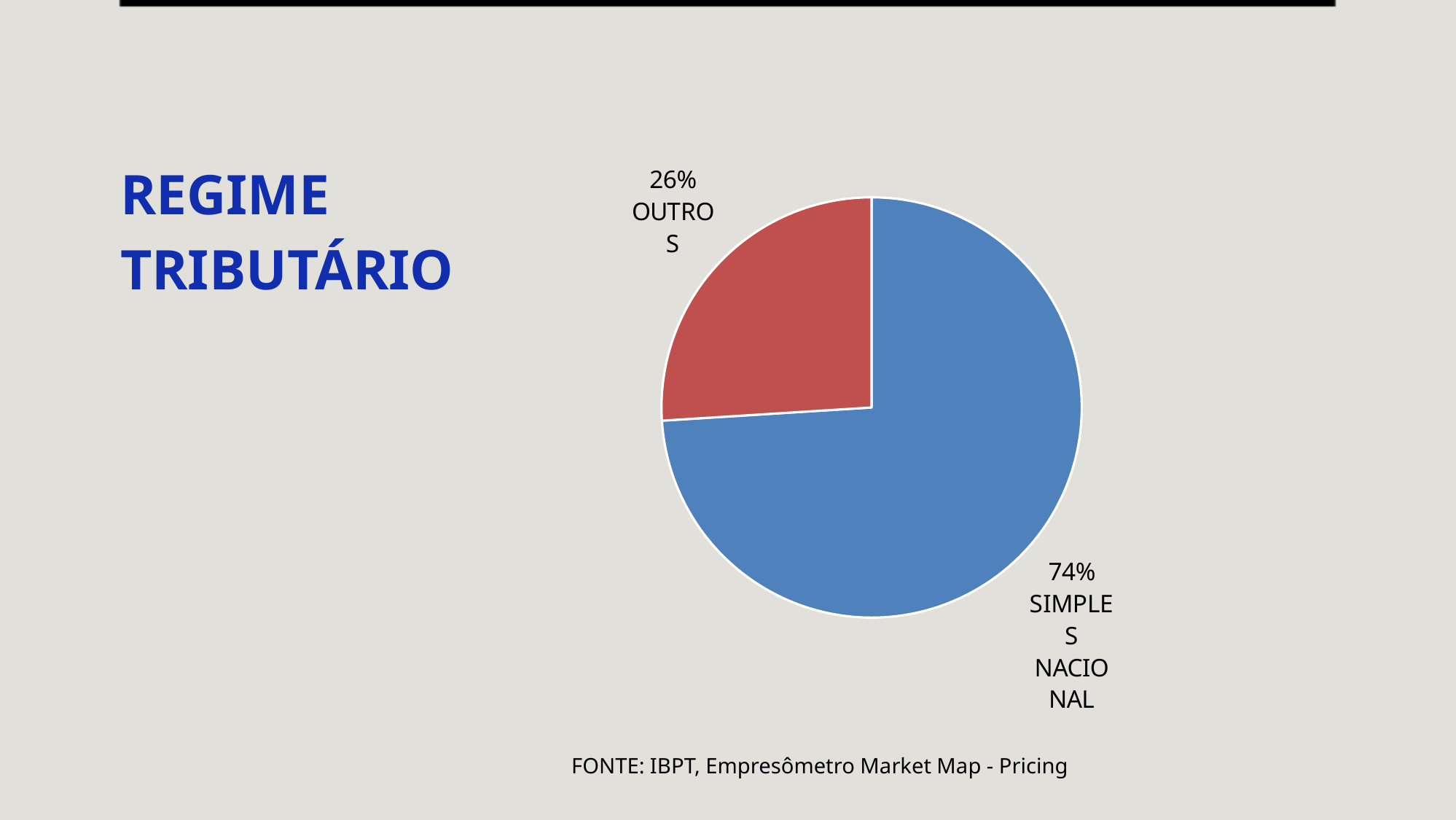
What share of the pie does SIMPLES NACIONAL represent? 74% What is the difference in percentage points between SIMPLES NACIONAL and OUTROS? 48 What kind of chart is shown on the slide? Pie chart What colour is the SIMPLES NACIONAL slice? Blue Which is larger, the share for OUTROS or the share for SIMPLES NACIONAL? SIMPLES NACIONAL Which slice of the pie is the smallest? OUTROS What is the source cited below the chart? IBPT, Empresômetro Market Map - Pricing How many slices does the pie chart have? 2 Which slice of the pie is the largest? SIMPLES NACIONAL What share of the pie does OUTROS represent? 26%